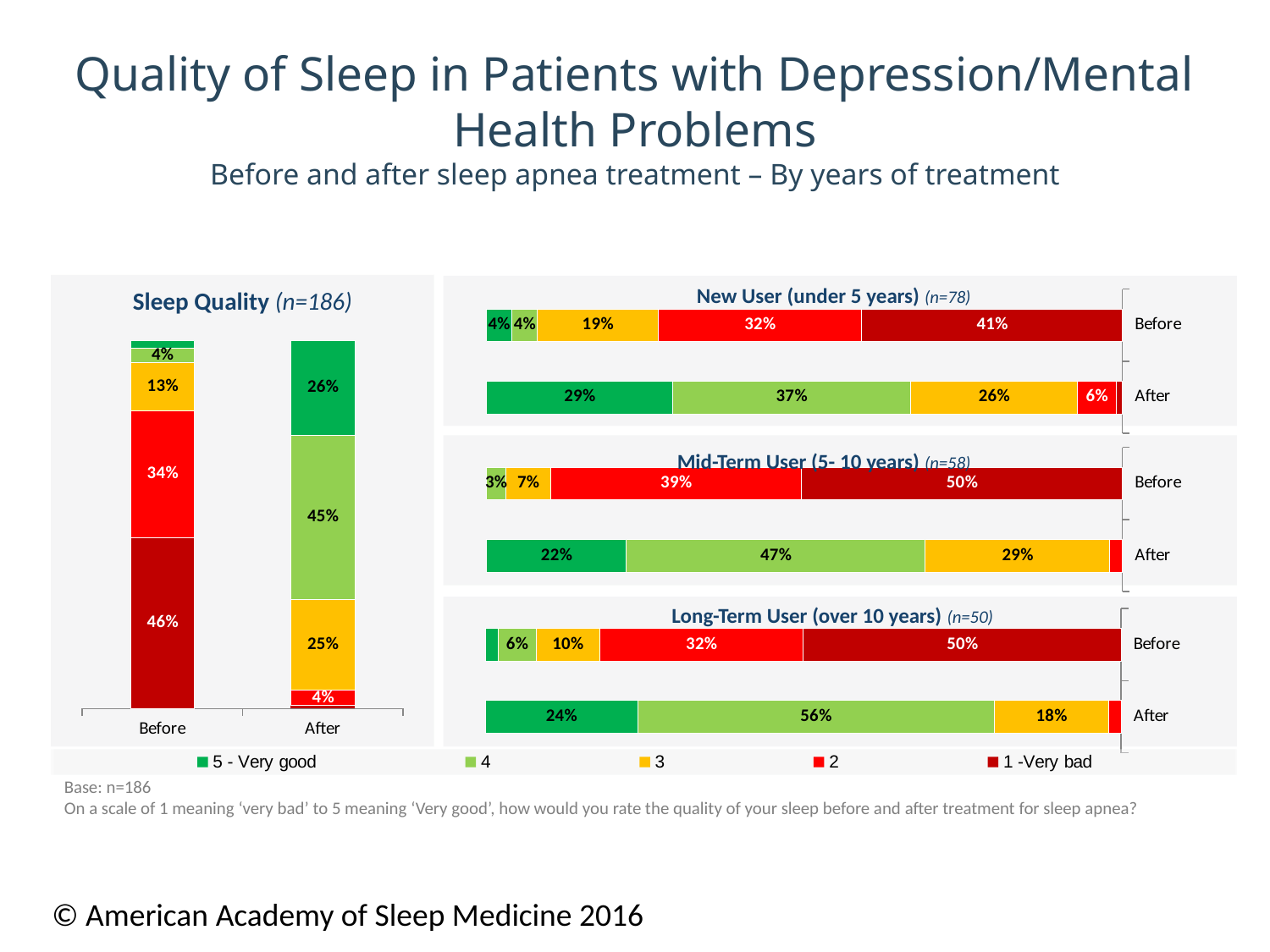
In the Long-Term User (over 10 years) chart, what is the value of the '4' segment in the After bar? 56% In the Mid-Term User (5-10 years) chart, what percentage rated their sleep '2' before treatment? 39% In the Sleep Quality (n=186) chart, what is the value of the '4' segment in the After bar? 45% In the Long-Term User (over 10 years) chart, which is larger in the Before bar: the '1 - Very bad' segment or the '2' segment? 1 - Very bad In the New User (under 5 years) chart, what percentage rated their sleep '1 - Very bad' before treatment? 41% In the Mid-Term User (5-10 years) chart, which rating has the largest segment in the After bar? 4 In the Sleep Quality (n=186) chart, by how many percentage points does the '3' rating increase from Before to After? 12 percentage points How many series does the legend at the bottom of the slide list? 5 In the New User (under 5 years) chart, what is the value of the '4' segment in the After bar? 37% In the New User (under 5 years) chart, by how many percentage points does the '5 - Very good' rating increase from Before to After? 25 percentage points What kind of chart is the Sleep Quality (n=186) chart on the left? Stacked bar chart In the Sleep Quality (n=186) chart, what percentage of patients rated their sleep '1 - Very bad' before treatment? 46%